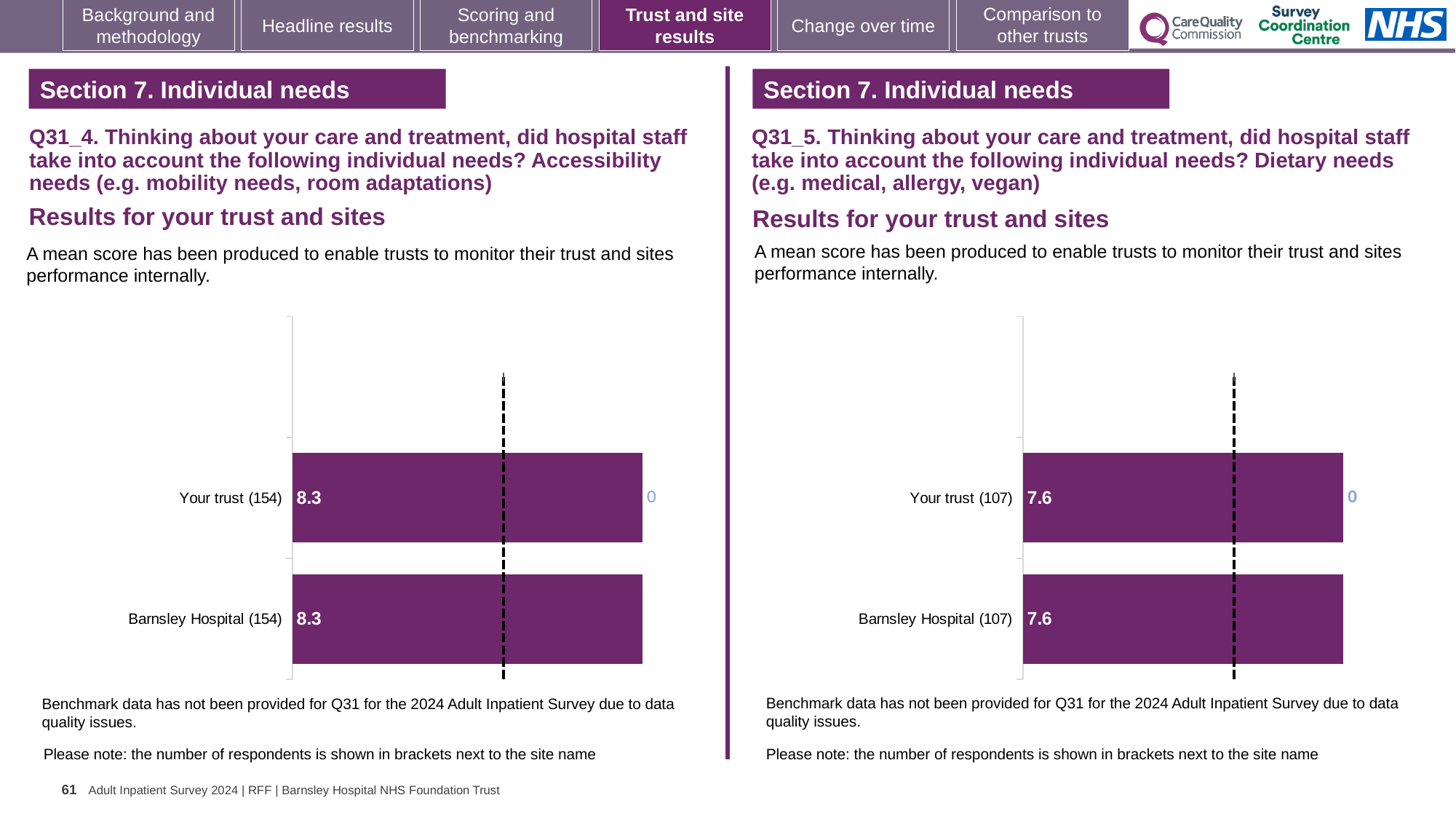
Which is larger: the Your trust score in the left chart (Q31_4) or the Your trust score in the right chart (Q31_5)? Left chart (Q31_4), 8.3 In the right chart (Q31_5, Dietary needs), how many categories are shown? 2 In the left chart (Q31_4, Accessibility needs), how many bars are plotted? 2 In the left chart (Q31_4, Accessibility needs), what is the difference between the scores for Your trust and Barnsley Hospital? 0 In the right chart (Q31_5, Dietary needs), what is the mean score for Barnsley Hospital? 7.6 What type of chart is used in the left chart (Q31_4, Accessibility needs)? Bar chart In the left chart (Q31_4, Accessibility needs), what is the mean score for Your trust? 8.3 In the left chart (Q31_4, Accessibility needs), how many respondents are shown in brackets next to Your trust? 154 In the right chart (Q31_5, Dietary needs), how many respondents are shown in brackets next to Barnsley Hospital? 107 In the left chart (Q31_4, Accessibility needs), what is the mean score for Barnsley Hospital? 8.3 In the right chart (Q31_5, Dietary needs), what is the difference between the scores for Your trust and Barnsley Hospital? 0 In the right chart (Q31_5, Dietary needs), what is the mean score for Your trust? 7.6